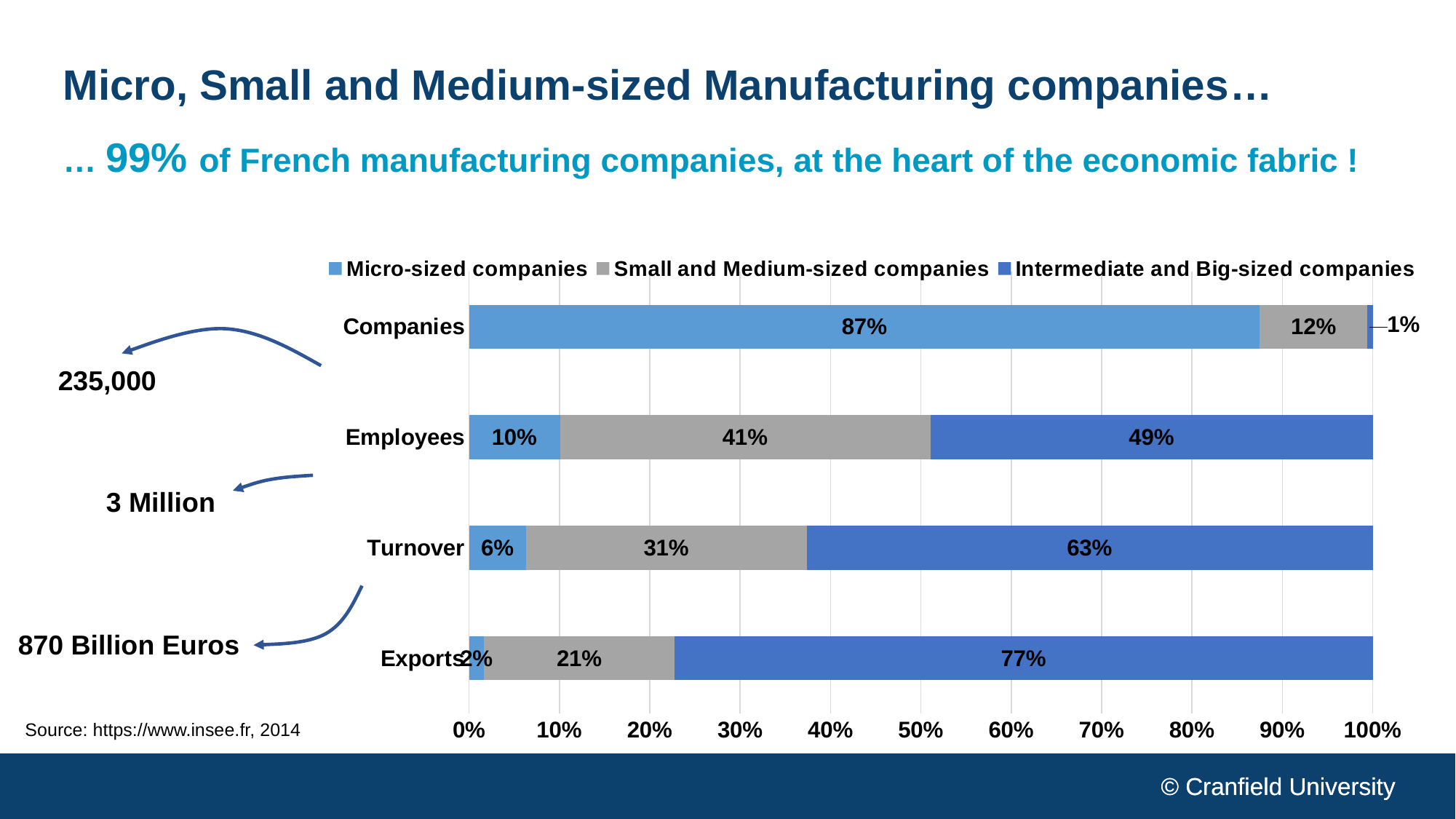
What is the value for Intermediate and Big-sized companies in the Exports category? 77% What share of Companies is made up of Micro-sized companies? 87% How many categories are shown on the chart? 4 How many series does the legend list? 3 Which category has the highest value for Intermediate and Big-sized companies? Exports What kind of chart is shown on the slide? Stacked bar chart What is the value for Small and Medium-sized companies in the Employees category? 41% Which category has the lowest value for Micro-sized companies? Exports Which is larger: the Small and Medium-sized companies value for Employees or for Turnover? Employees What is the total of the Employees bar? 100% What is the difference between the Intermediate and Big-sized companies values for Turnover and Employees? 14% What is the value for Micro-sized companies in the Turnover category? 6%